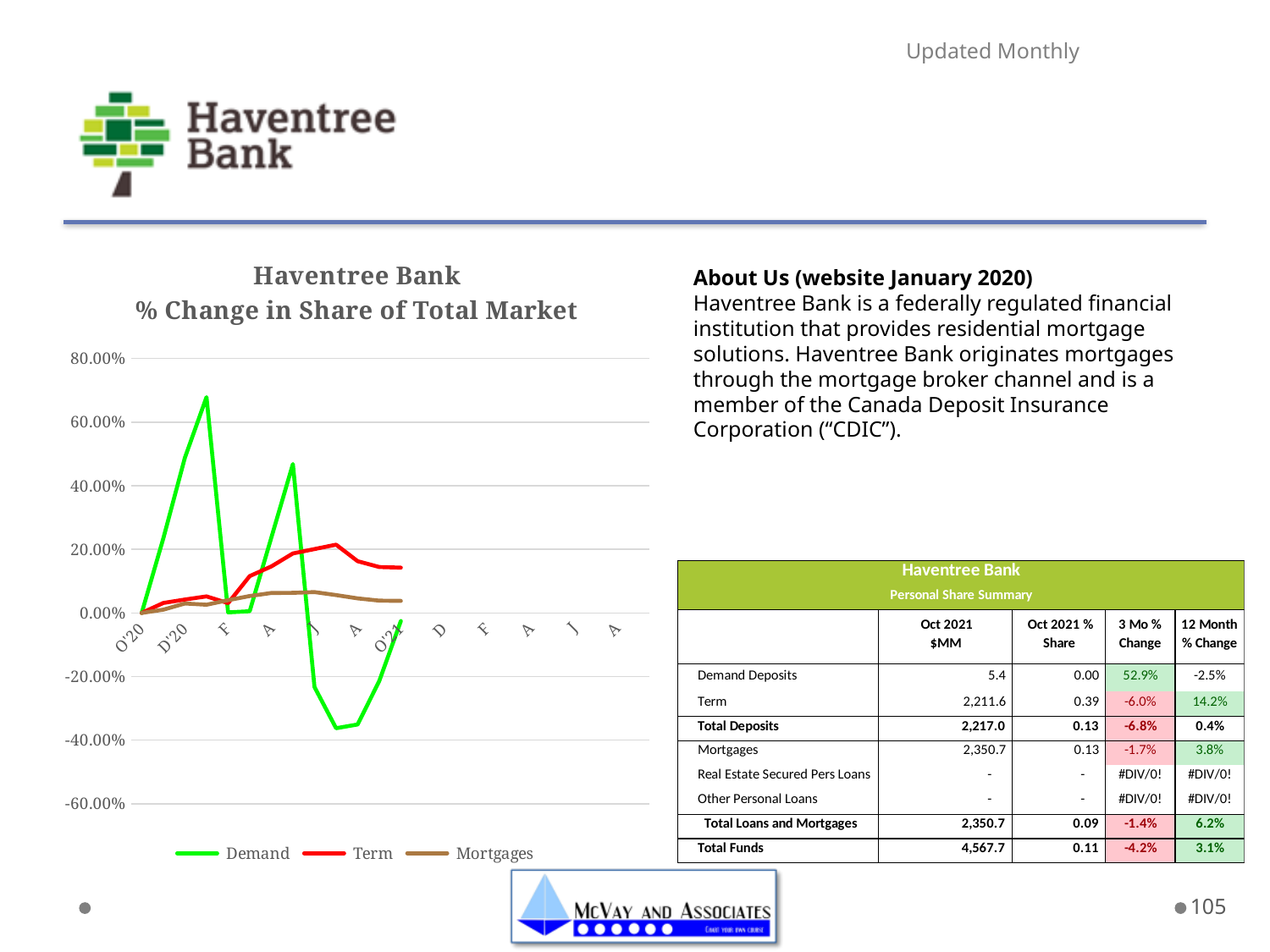
How many labels are shown along the x axis of the chart? 12 How many series does the legend of the chart list? 3 Which series reaches the lowest value on the chart? Demand At O'21, which series has the larger value, Term or Mortgages? Term What are the three series named in the chart legend? Demand, Term, Mortgages Is the value of the Term series at O'21 greater or less than 0.00%? greater Is the peak value of the Demand series greater or less than 60.00%? greater What is the title of the chart? Haventree Bank % Change in Share of Total Market Which series reaches the highest value on the chart? Demand What kind of chart is shown on the slide? line chart Does the Mortgages series ever rise above 20.00%? No